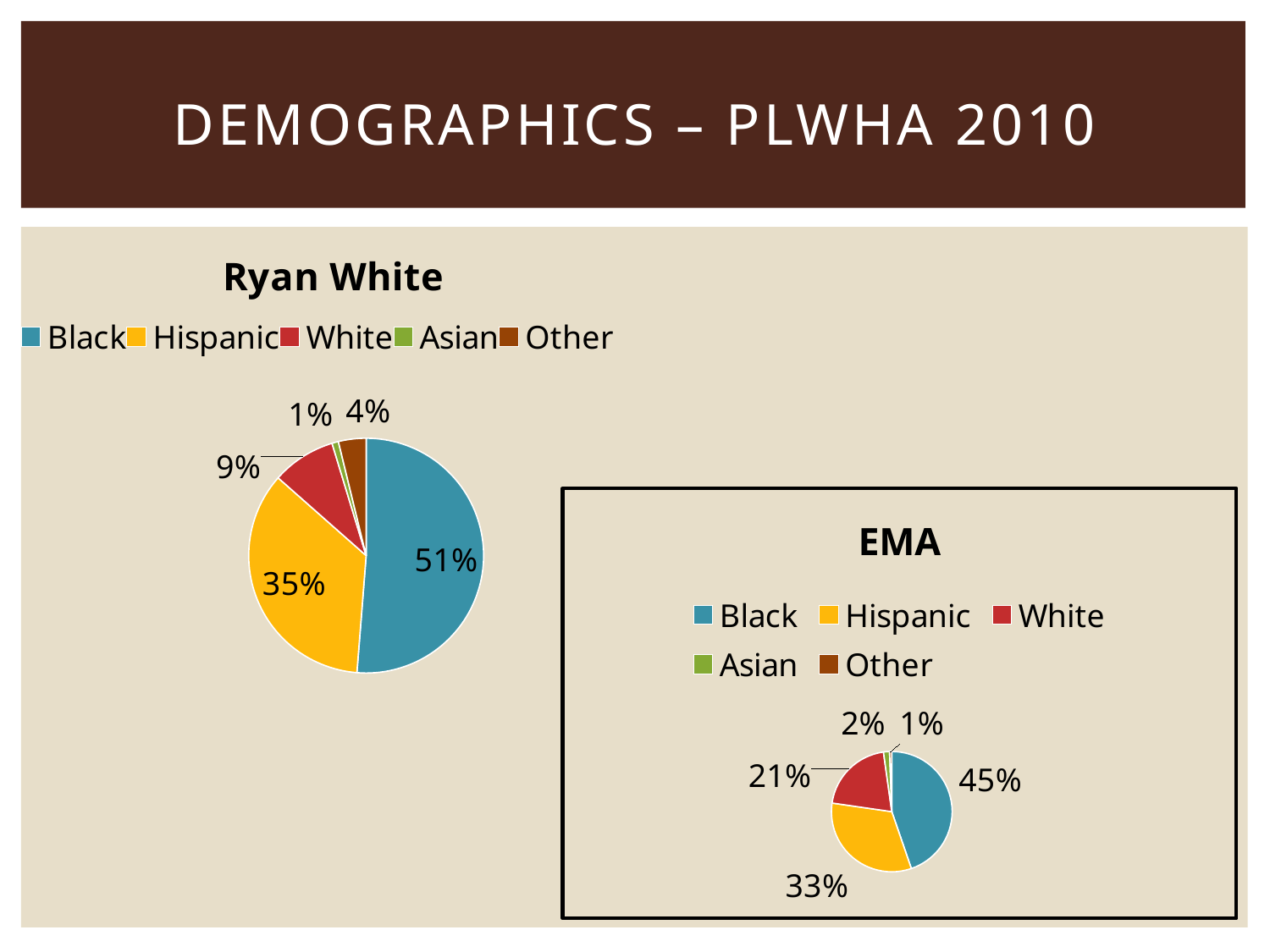
In the EMA chart, what percentage is White? 21% In the Ryan White chart, what colour represents Hispanic? Yellow How many categories does the Ryan White chart show? 5 In the EMA chart, which category has the largest share? Black In the EMA chart, what percentage is Hispanic? 33% What is the difference between the Black share in the Ryan White chart and the Black share in the EMA chart? 6% In the Ryan White chart, what percentage is Black? 51% What kind of chart is the EMA chart? Pie chart In the Ryan White chart, which category has the largest share? Black In the Ryan White chart, which category has the smallest share? Asian In the Ryan White chart, what percentage is Hispanic? 35% Which is larger: the White share in the Ryan White chart or the White share in the EMA chart? EMA